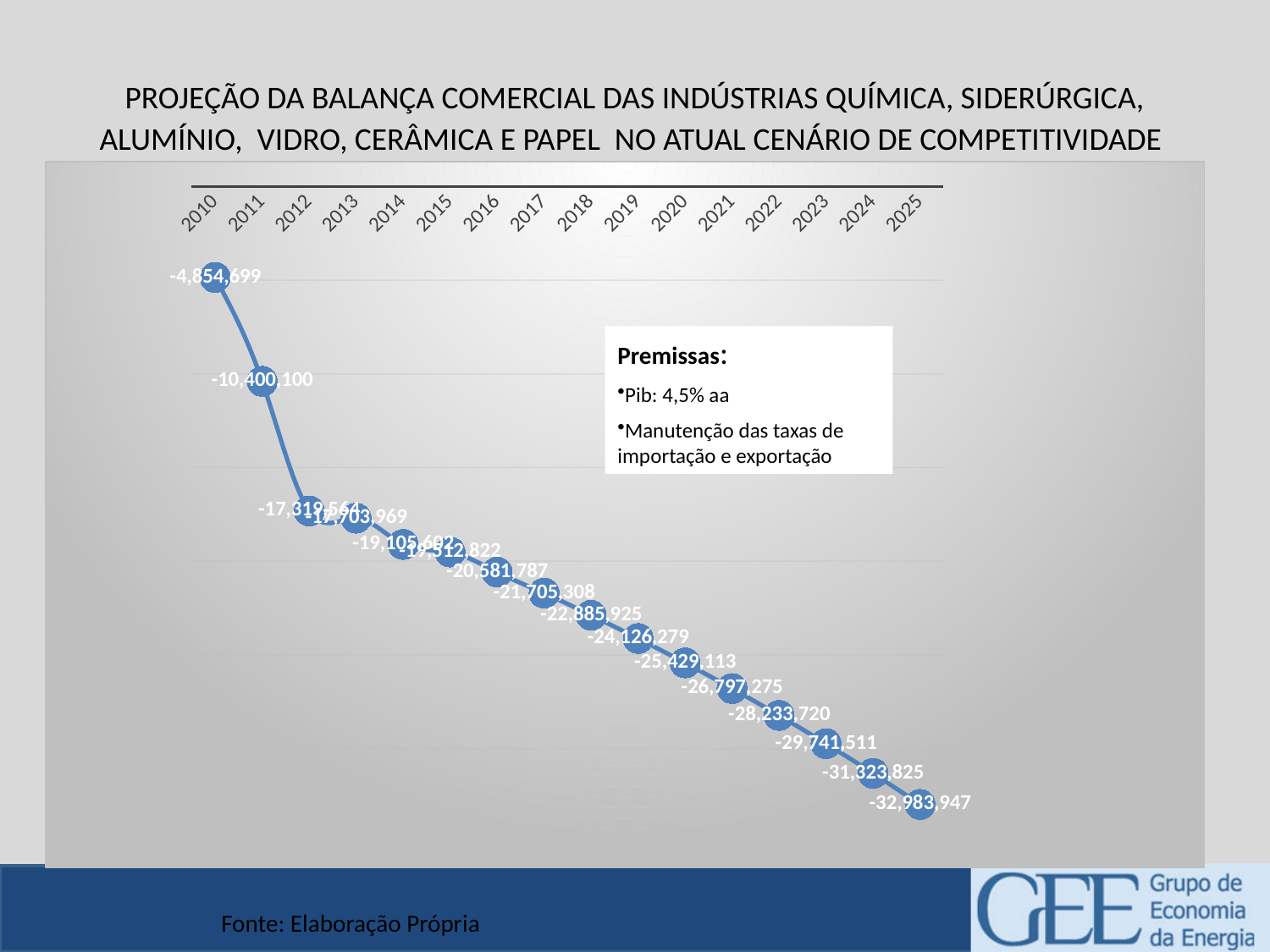
What is the difference between the values for 2024 and 2025? 1,660,122 Which is larger, the value for 2018 or the value for 2019? 2018 What is the value for 2016? -20,581,787 How many years are plotted on the x axis? 16 What is the value for 2025? -32,983,947 Which year has the lowest (most negative) value? 2025 What is the value for 2023? -29,741,511 Which year has the highest (least negative) value? 2010 What is the value for 2010? -4,854,699 What is the value for 2020? -25,429,113 Do the values rise or fall from 2010 to 2025? Fall What kind of chart is shown? Line chart